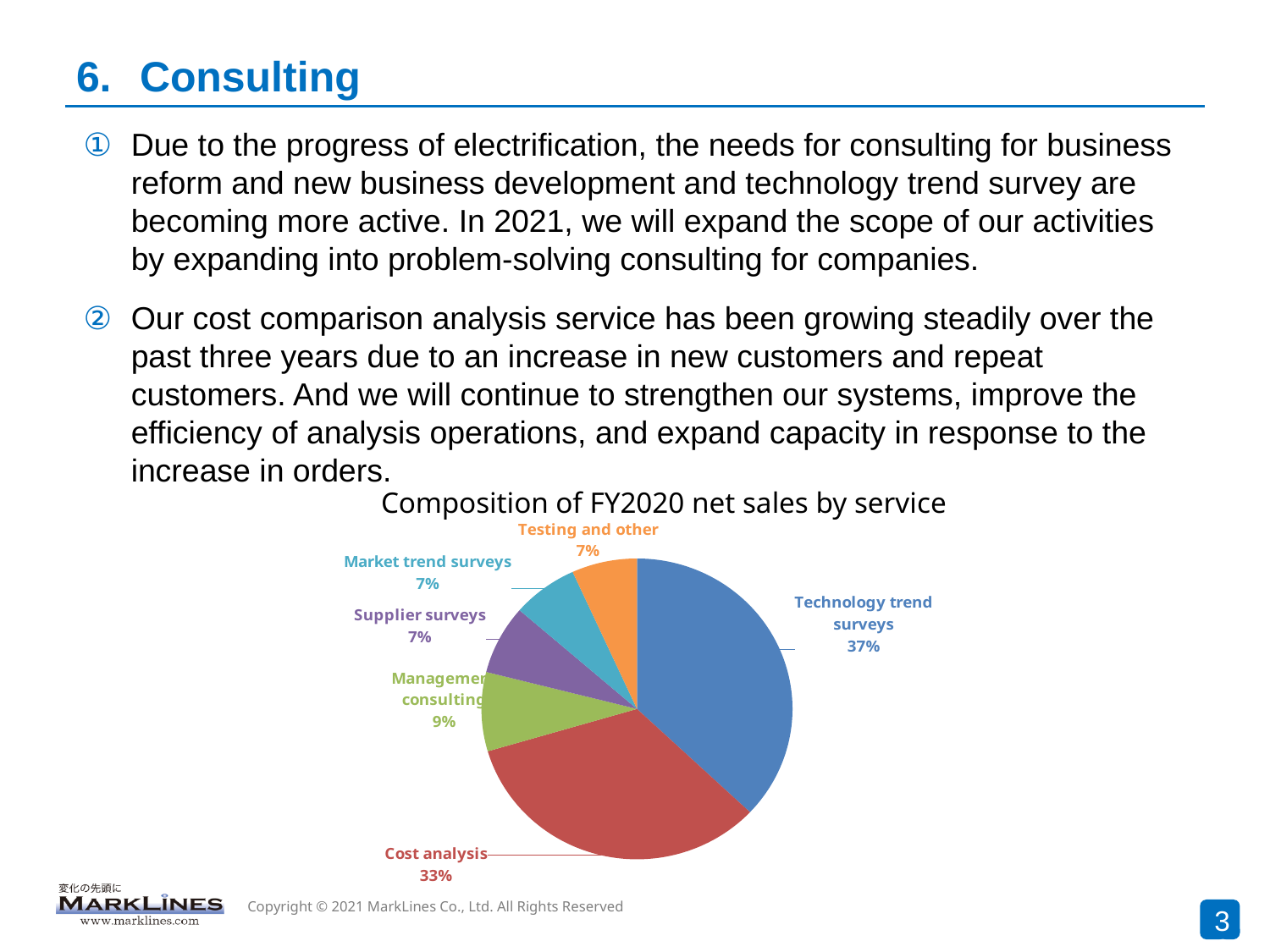
What kind of chart is shown on the slide? Pie chart How many services (slices) are shown in the pie chart? 6 What percentage is shown for Supplier surveys? 7% Which has a larger share, Management consulting or Market trend surveys? Management consulting Which service has the largest share of FY2020 net sales? Technology trend surveys What percentage is shown for Testing and other? 7% What is the difference in percentage points between Technology trend surveys and Cost analysis? 4 percentage points What is the title of the chart? Composition of FY2020 net sales by service What share of FY2020 net sales comes from Technology trend surveys? 37% What percentage is shown for Management consulting? 9% What is the combined share of Supplier surveys, Market trend surveys, and Testing and other? 21% What share of FY2020 net sales comes from Cost analysis? 33%